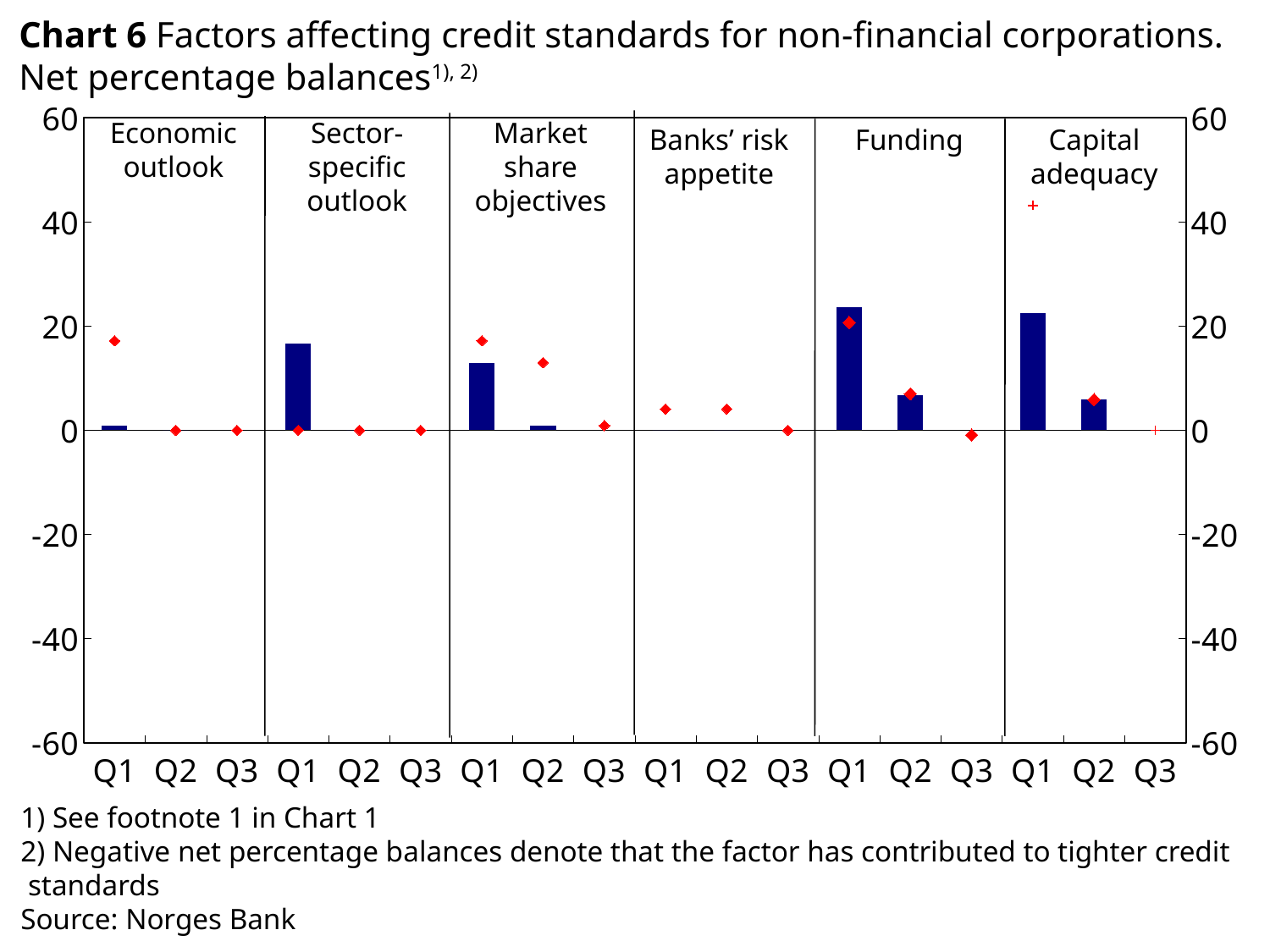
What is the source given for the chart? Norges Bank Is the Q1 bar for Market share objectives greater or less than 20? less How many quarters are shown on the x axis within each factor panel? 3 Is the Q1 bar for Funding greater or less than 20? greater What is the highest value shown on the vertical axis? 60 What kind of chart is shown on the slide? combination bar and line chart (bars with red diamond markers) Do the bars for Capital adequacy rise or fall from Q1 to Q2? fall How many factor panels are shown in the chart? 6 Which is larger, the Q1 bar or the Q2 bar for Funding? Q1 Is the red marker for Q1 under Capital adequacy greater or less than 40? greater Which is larger, the Q1 bar for Sector-specific outlook or the Q1 bar for Market share objectives? Sector-specific outlook